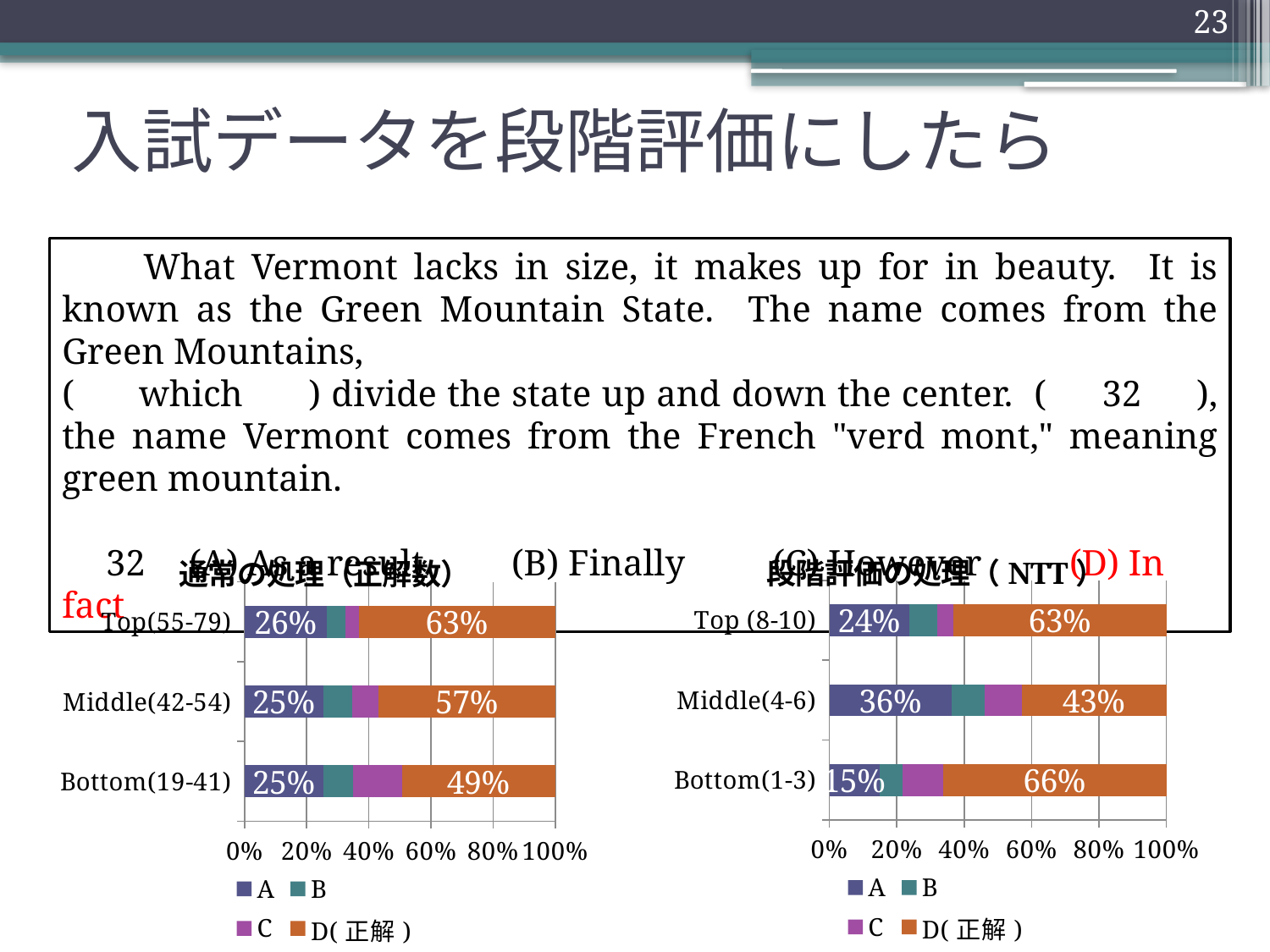
In the left chart, what is the difference between the D(正解) values for Top(55-79) and Bottom(19-41)? 14% In the left chart, what is the value of series D(正解) for Bottom(19-41)? 49% In the right chart, which is larger: the D(正解) value for Middle(4-6) or for Top(8-10)? Top(8-10) How many categories are shown in the left chart? 3 What type of chart is the right chart? Stacked bar chart In the left chart, what is the value of series A for Middle(42-54)? 25% In the right chart, what is the value of series D(正解) for Bottom(1-3)? 66% In the right chart, which category has the highest value for series D(正解)? Bottom(1-3) In the left chart, which category has the lowest value for series D(正解)? Bottom(19-41) In the right chart, what is the value of series A for Middle(4-6)? 36% In the left chart, what is the value of series D(正解) for Top(55-79)? 63% How many series does the legend of the right chart list? 4